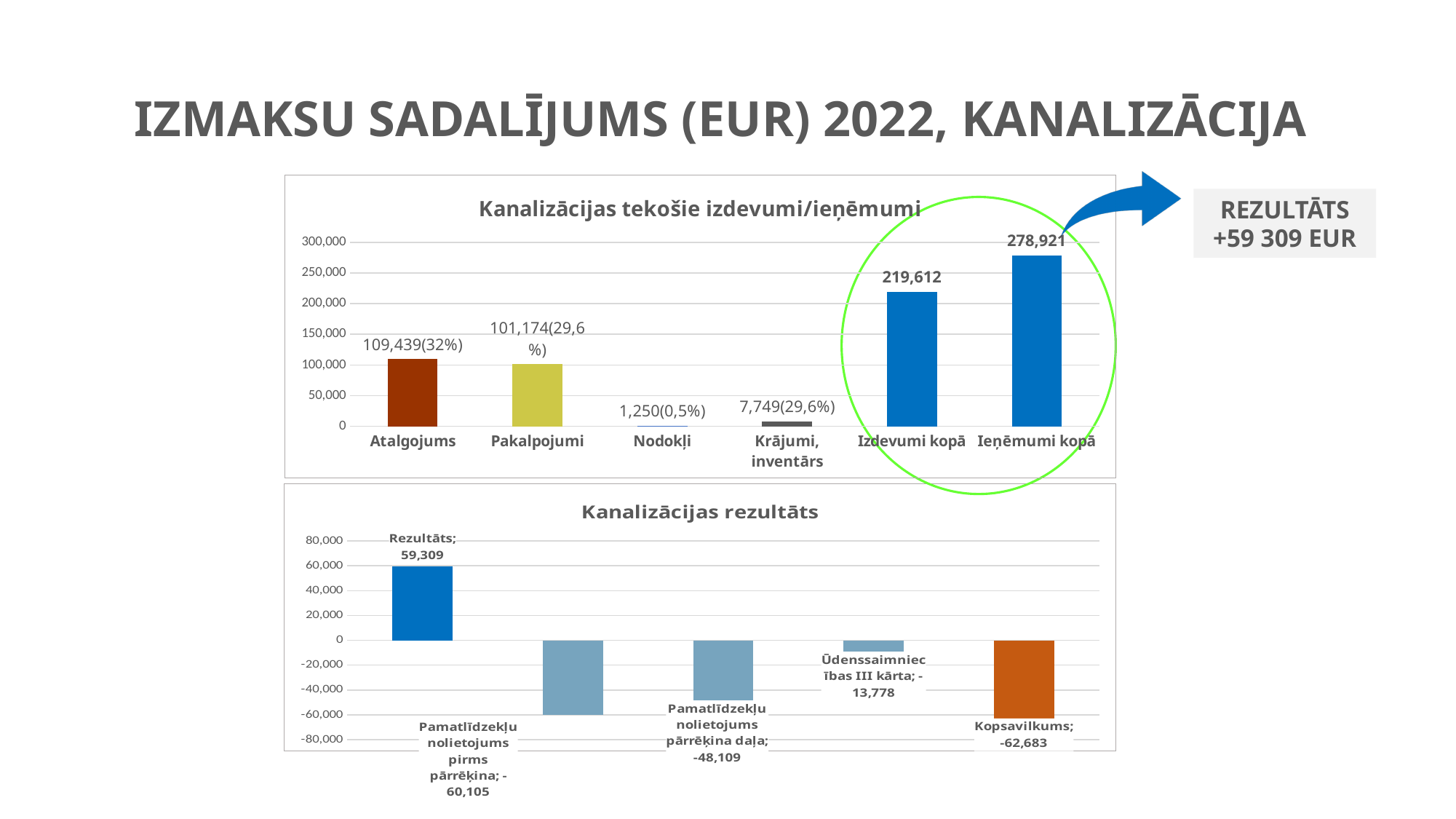
In the chart 'Kanalizācijas tekošie izdevumi/ieņēmumi', what is the difference between Ieņēmumi kopā and Izdevumi kopā? 59,309 What kind of chart is 'Kanalizācijas rezultāts'? Bar chart In the chart 'Kanalizācijas tekošie izdevumi/ieņēmumi', what is the data label for Nodokļi? 1,250(0,5%) In the chart 'Kanalizācijas tekošie izdevumi/ieņēmumi', which category has the lowest value? Nodokļi In the chart 'Kanalizācijas tekošie izdevumi/ieņēmumi', how many categories are shown on the x axis? 6 In the chart 'Kanalizācijas tekošie izdevumi/ieņēmumi', which is larger, Atalgojums or Pakalpojumi? Atalgojums In the chart 'Kanalizācijas tekošie izdevumi/ieņēmumi', which category has the highest value? Ieņēmumi kopā In the chart 'Kanalizācijas rezultāts', what is the value for Ūdenssaimniecības III kārta? -13,778 In the chart 'Kanalizācijas rezultāts', what is the value for Kopsavilkums? -62,683 In the chart 'Kanalizācijas tekošie izdevumi/ieņēmumi', what is the value for Ieņēmumi kopā? 278,921 In the chart 'Kanalizācijas tekošie izdevumi/ieņēmumi', what is the value for Izdevumi kopā? 219,612 In the chart 'Kanalizācijas rezultāts', which category has the lowest value? Kopsavilkums